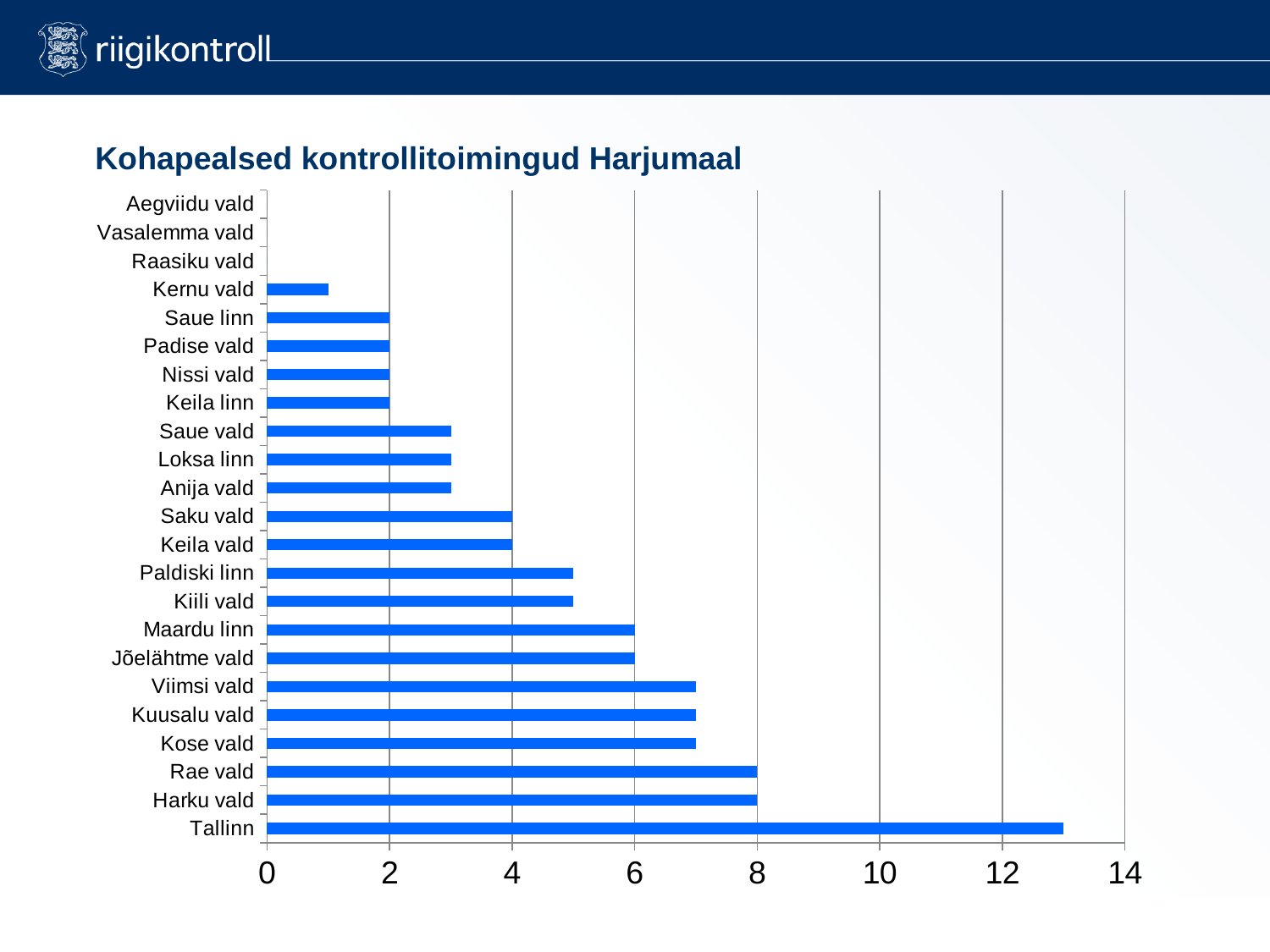
How many categories are plotted on the chart? 23 Which is larger, the value for Rae vald or the value for Jõelähtme vald? Rae vald What is the difference between the values for Rae vald and Keila vald? 4 What is the title of the chart? Kohapealsed kontrollitoimingud Harjumaal What is the value for Saku vald? 4 What is the value for Harku vald? 8 Which category has the highest value? Tallinn What is the value for Nissi vald? 2 What is the value for Maardu linn? 6 Is the value for Kernu vald greater or less than 2? less Is the value for Tallinn greater or less than 12? greater What kind of chart is shown on the slide? bar chart